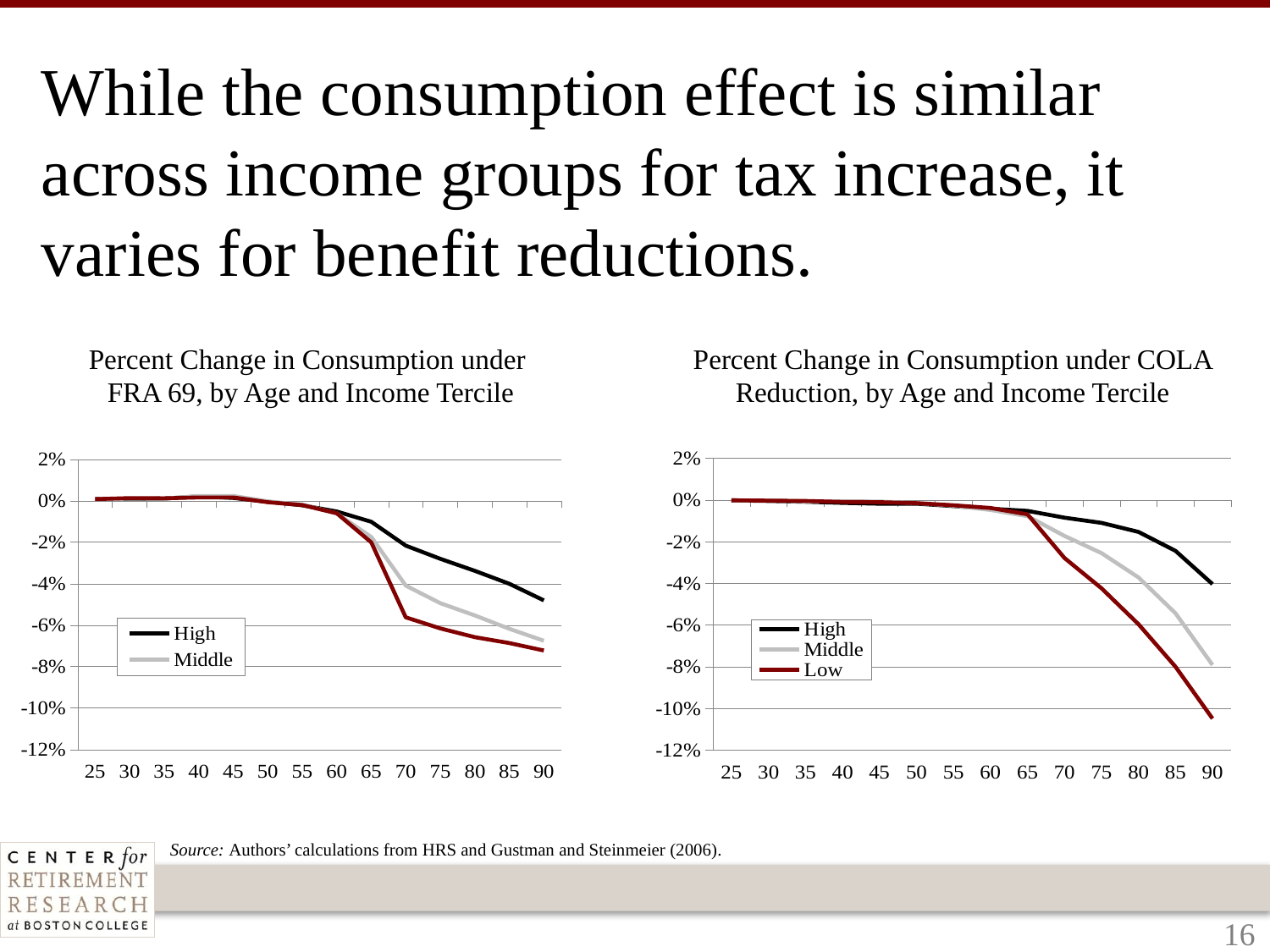
What kind of chart is the left chart, 'Percent Change in Consumption under FRA 69, by Age and Income Tercile'? Line chart What is the title of the left chart on the slide? Percent Change in Consumption under FRA 69, by Age and Income Tercile In the right chart, 'Percent Change in Consumption under COLA Reduction', which is larger at age 90, the value for High or the value for Low? High In the right chart, 'Percent Change in Consumption under COLA Reduction', is the value for Low at age 90 greater or less than -8%? less In the left chart, 'Percent Change in Consumption under FRA 69', is the value for Middle at age 90 greater or less than -6%? less In the left chart, 'Percent Change in Consumption under FRA 69', is the value for High at age 90 greater or less than -4%? less How many series does the legend list in the right chart, 'Percent Change in Consumption under COLA Reduction, by Age and Income Tercile'? 3 How many age points are labeled on the x axis of the right chart, 'Percent Change in Consumption under COLA Reduction'? 14 In the right chart, 'Percent Change in Consumption under COLA Reduction', do the values for the Low series rise or fall as age increases? Fall How many series does the legend list in the left chart, 'Percent Change in Consumption under FRA 69, by Age and Income Tercile'? 2 In the right chart, 'Percent Change in Consumption under COLA Reduction', which series has the lowest value at age 90? Low